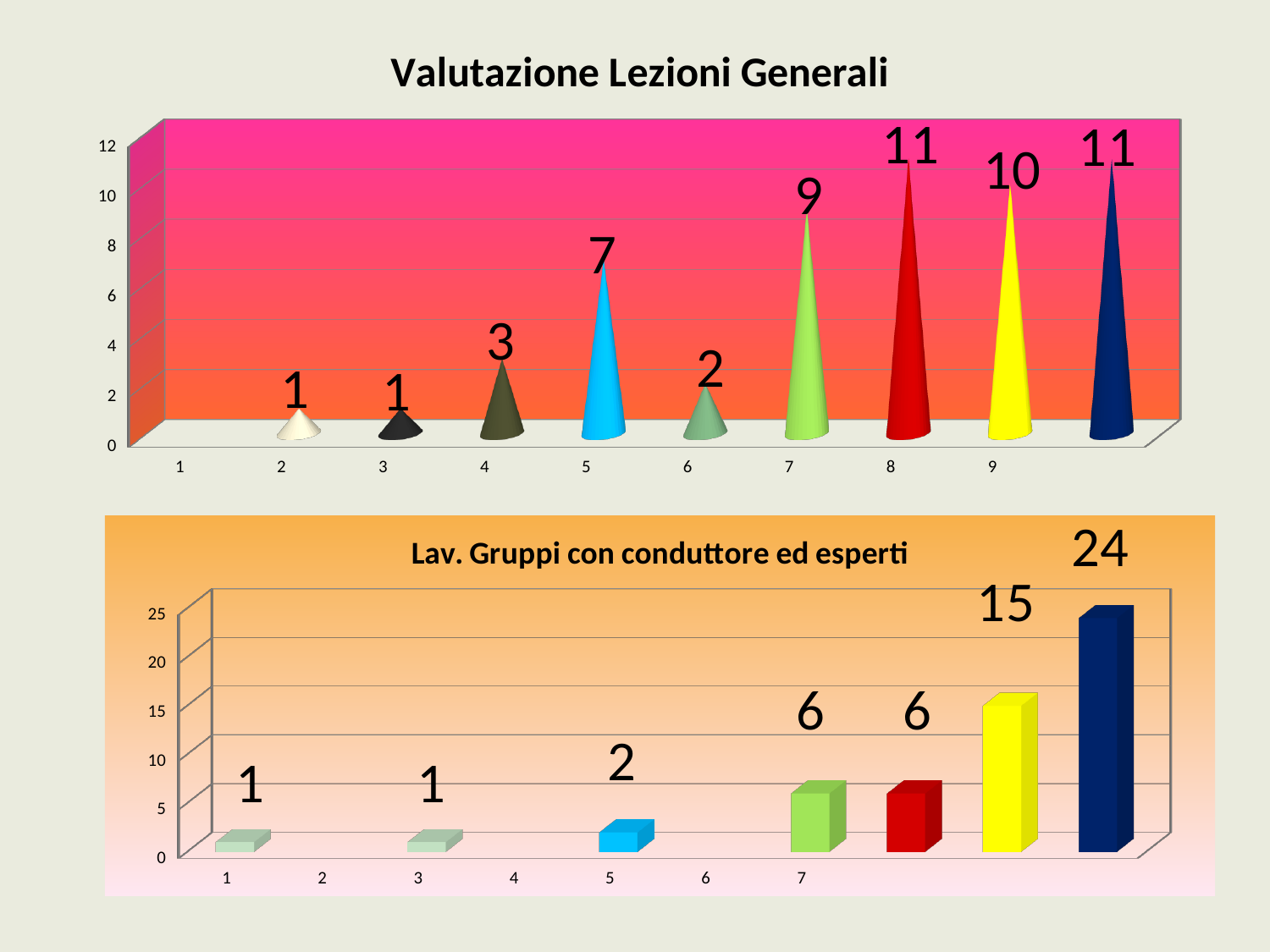
In the chart titled 'Valutazione Lezioni Generali', what is the value for category 5? 7 In the chart titled 'Lav. Gruppi con conduttore ed esperti', what is the difference between the tallest bar's value and the value for category 7? 18 What is the title of the top chart on the slide? Valutazione Lezioni Generali In the chart titled 'Valutazione Lezioni Generali', what is the value for category 7? 9 In the chart titled 'Lav. Gruppi con conduttore ed esperti', what is the value for category 7? 6 In the chart titled 'Valutazione Lezioni Generali', do the values generally rise or fall from left to right? Rise What kind of chart is the bottom chart titled 'Lav. Gruppi con conduttore ed esperti'? Bar chart In the chart titled 'Lav. Gruppi con conduttore ed esperti', what is the highest value shown? 24 In the chart titled 'Lav. Gruppi con conduttore ed esperti', what is the value for category 5? 2 In the chart titled 'Valutazione Lezioni Generali', what is the value for category 9? 10 In the chart titled 'Valutazione Lezioni Generali', which has the larger value, category 5 or category 6? Category 5 In the chart titled 'Valutazione Lezioni Generali', what is the difference between the value for category 8 and the value for category 4? 8